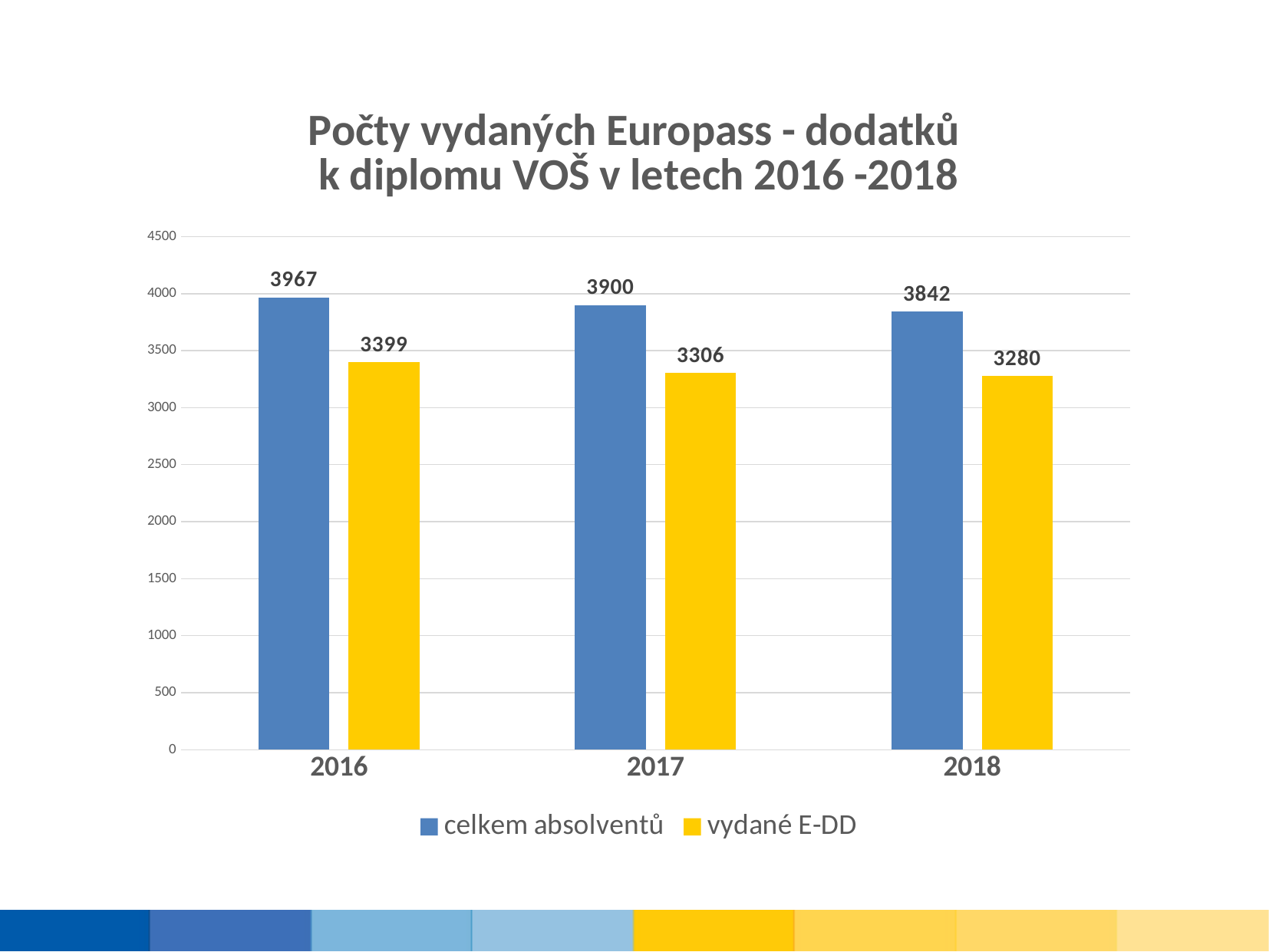
How many years are shown on the x axis? 3 What is the difference between 'celkem absolventů' and 'vydané E-DD' in 2017? 594 What is the value of 'vydané E-DD' for 2017? 3306 Does 'celkem absolventů' rise or fall from 2016 to 2018? fall Is the value of 'celkem absolventů' for 2018 greater or less than 3500? greater What kind of chart is shown on the slide? bar chart What is the value of 'vydané E-DD' for 2018? 3280 In which year is 'vydané E-DD' lowest? 2018 Which is larger: 'vydané E-DD' in 2016 or 'vydané E-DD' in 2018? vydané E-DD in 2016 How many series does the legend list? 2 What is the value of 'celkem absolventů' for 2016? 3967 In which year is 'celkem absolventů' highest? 2016